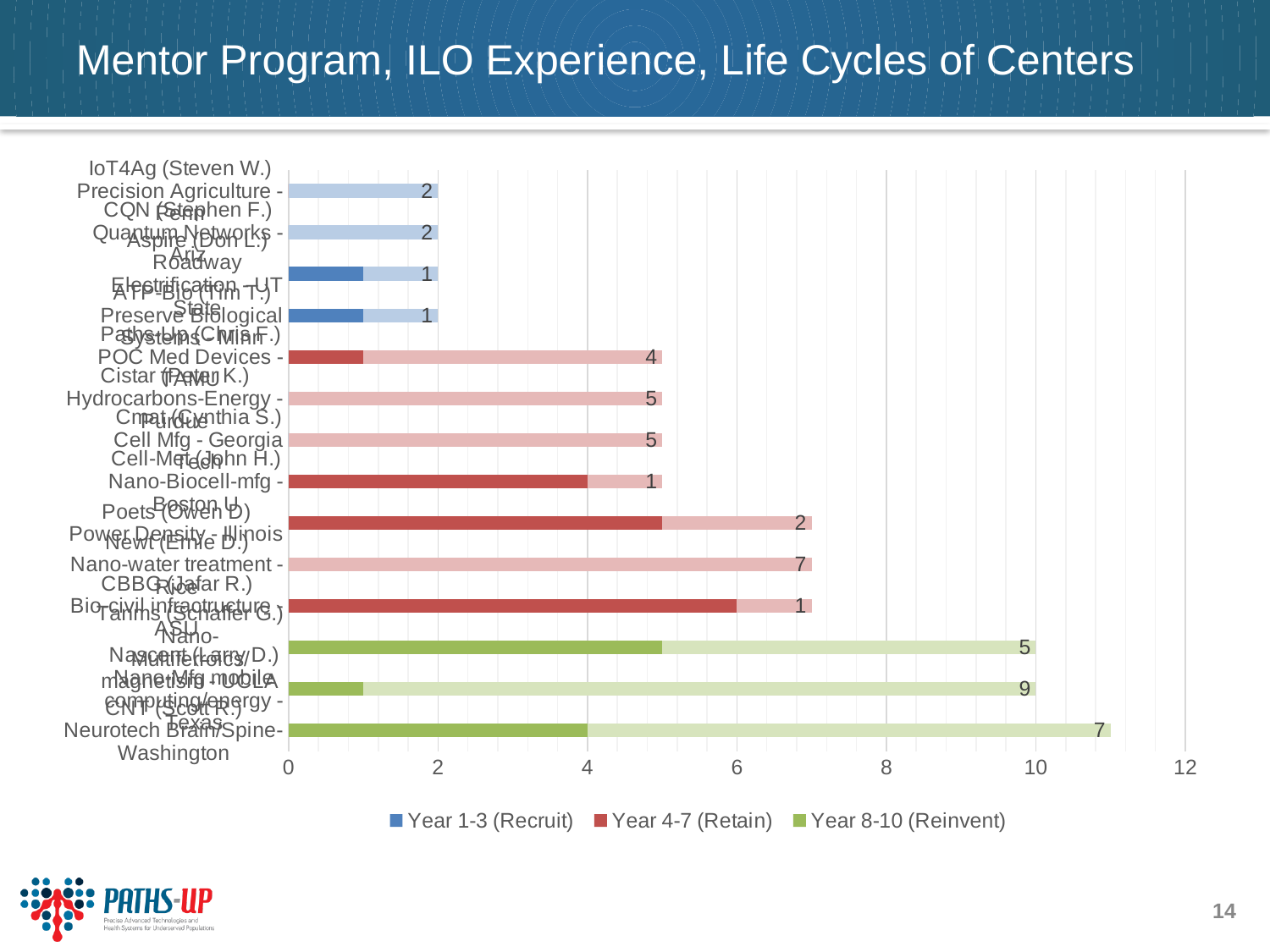
What is the data label printed on the second bar from the bottom? 9 What is the largest data label value printed on any bar? 9 Which series does the longest bar in the chart belong to? Year 8-10 (Reinvent) What kind of chart is shown on the slide? bar chart How many bars are plotted in the chart? 14 What is the maximum value shown on the horizontal axis? 12 What is the data label printed on the bottom bar of the chart? 7 How many series does the legend list? 3 Is the total length of the top bar greater or less than 4? less What are the three series named in the legend? Year 1-3 (Recruit), Year 4-7 (Retain), Year 8-10 (Reinvent) Is the total length of the bottom bar greater or less than 10? greater What is the data label printed on the top bar of the chart? 2